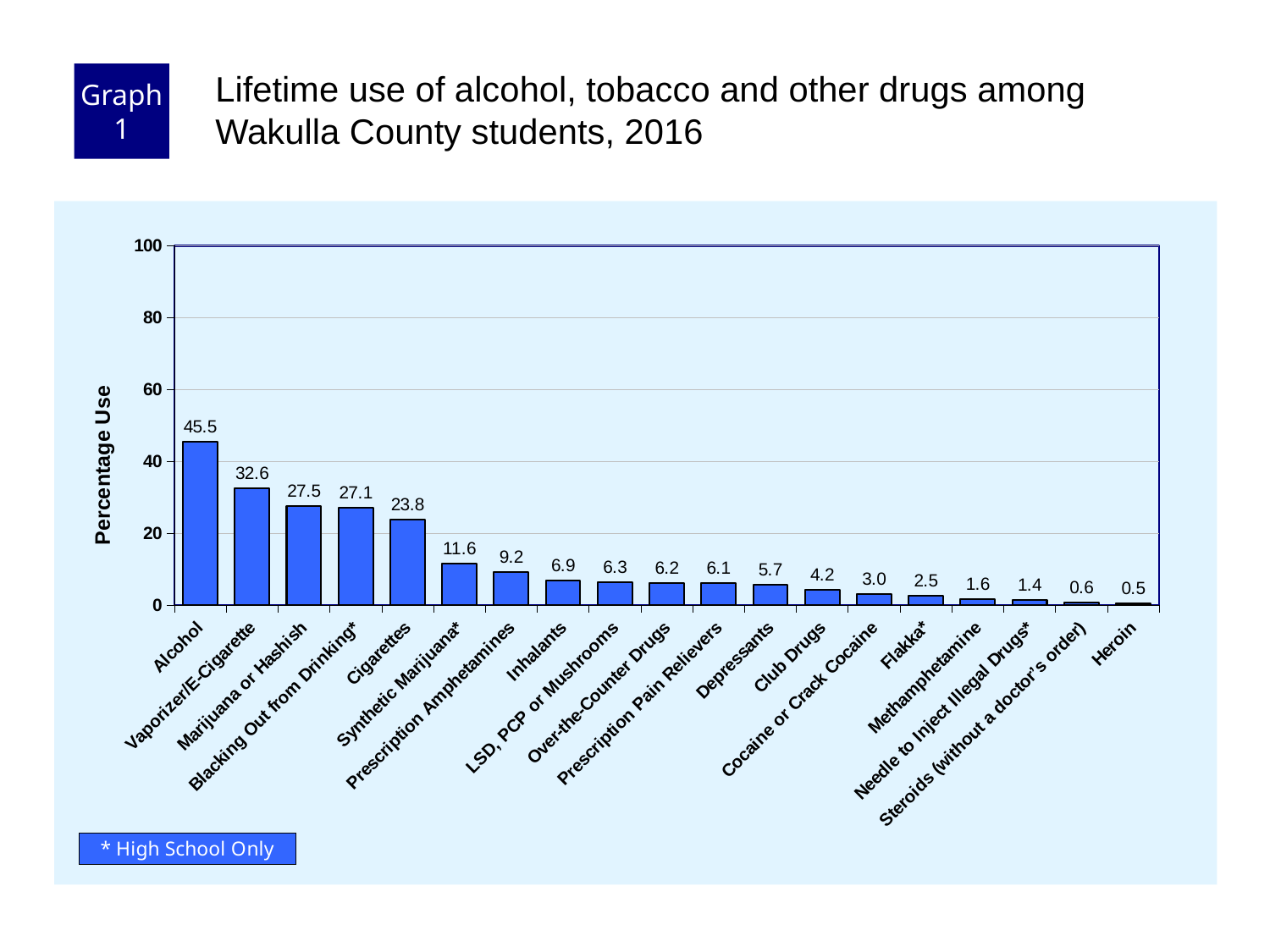
What kind of chart is shown on the slide? Bar chart What is the value shown for Vaporizer/E-Cigarette? 32.6 Which category has the highest lifetime use percentage? Alcohol Which category has the lowest lifetime use percentage? Heroin How many categories are shown on the x axis? 19 What is the value shown for Cocaine or Crack Cocaine? 3.0 Which is larger, the value for Inhalants or the value for Depressants? Inhalants What is the difference between the values for Alcohol and Cigarettes? 21.7 What is the lifetime use percentage for Alcohol? 45.5 Is the value for Marijuana or Hashish greater or less than 20? greater What is the label of the y axis? Percentage Use What is the value shown for Synthetic Marijuana*? 11.6